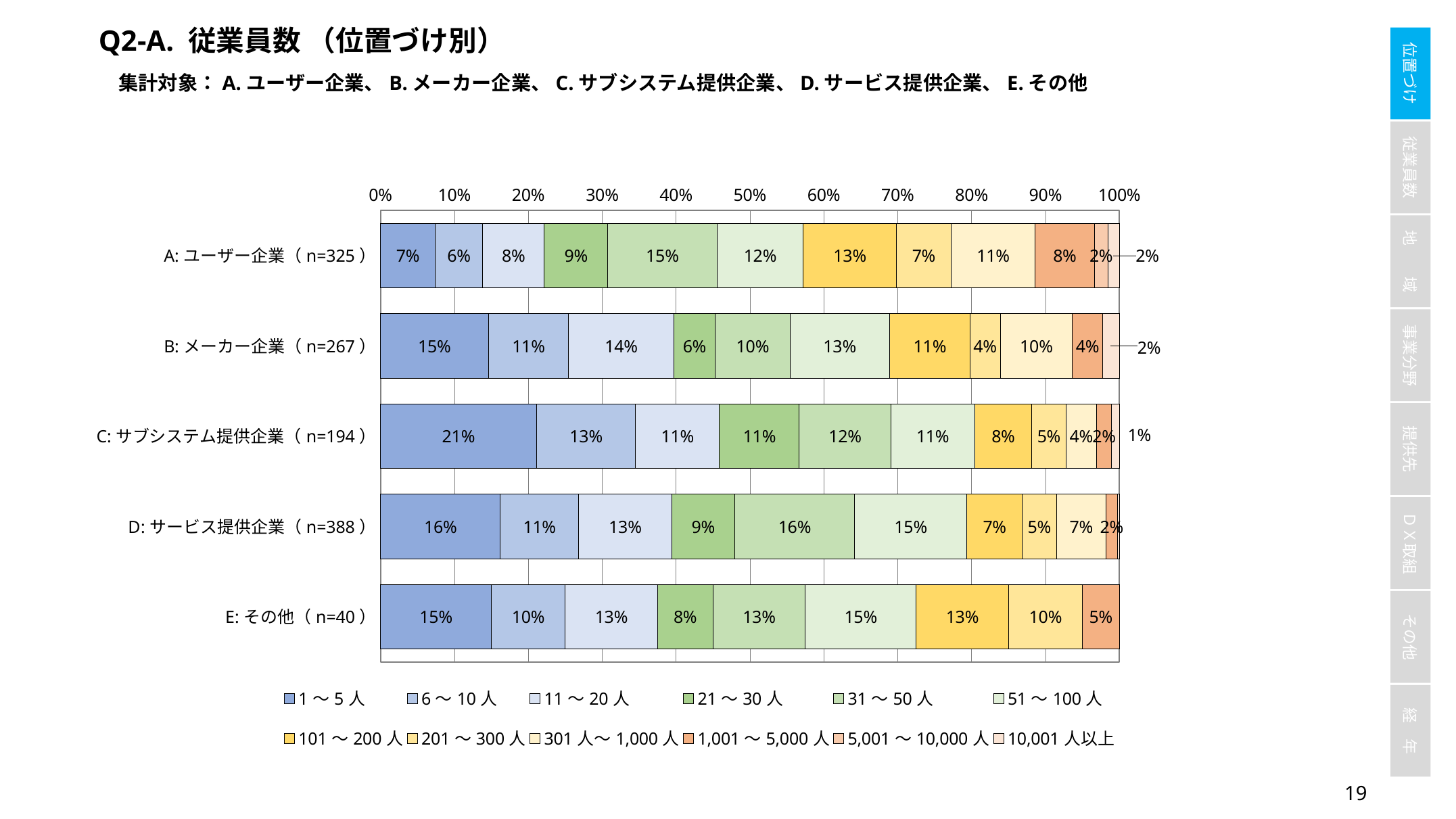
How many categories (company types) are plotted on the chart? 5 What is the value of the 101～200人 segment for E: その他? 13% What is the difference between the 1～5人 values for C: サブシステム提供企業 and A: ユーザー企業? 14% How many series does the legend list? 12 What kind of chart is shown on the slide? Stacked bar chart What is the value of the 31～50人 segment for A: ユーザー企業? 15% Which is larger: the 51～100人 value for D: サービス提供企業 or for C: サブシステム提供企業? D: サービス提供企業 Which category has the lowest value for the 1～5人 segment? A: ユーザー企業 What is the value of the 1～5人 segment for C: サブシステム提供企業? 21% Which category has the highest value for the 1～5人 segment? C: サブシステム提供企業 What is the value of the 11～20人 segment for B: メーカー企業? 14% What is the sample size (n) shown for D: サービス提供企業? 388